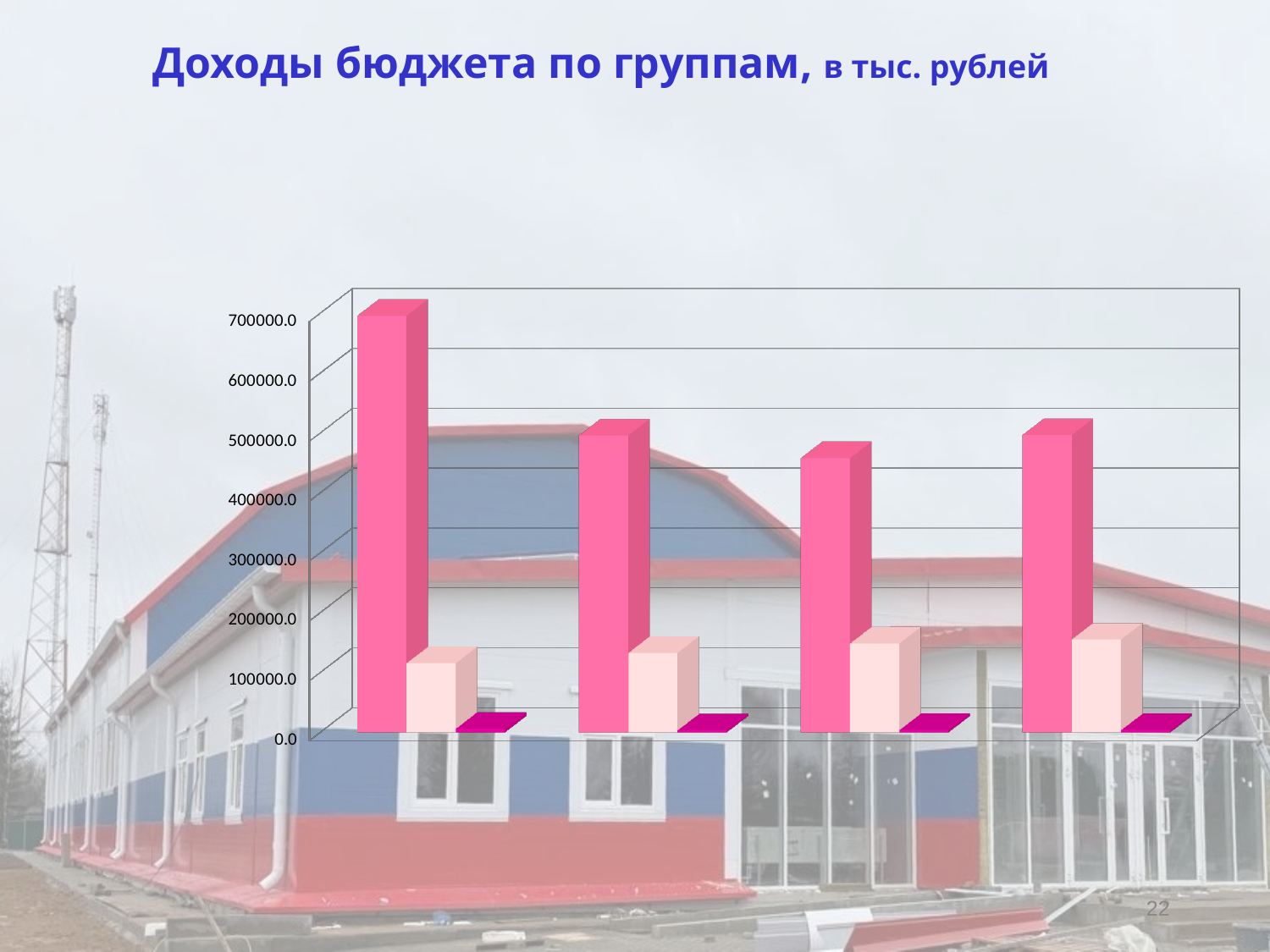
What is the highest value shown on the vertical axis of the chart? 700000.0 Do the light pink (middle) bars rise or fall from left to right across the groups? rise Which is larger: the tallest bar in the first group or the tallest bar in the third group? the first group What is the title of the chart on the slide? Доходы бюджета по группам, в тыс. рублей How many bars are there in each group of the chart? 3 Is the tallest bar in the second group greater or less than 600000.0? less How many groups of bars are plotted in the chart? 4 Which group of bars contains the tallest bar in the chart? the first (leftmost) group Is the light pink (middle) bar in the first group greater or less than 200000.0? less Is the tallest bar in the first (leftmost) group greater or less than 600000.0? greater What kind of chart is shown on the slide? bar chart